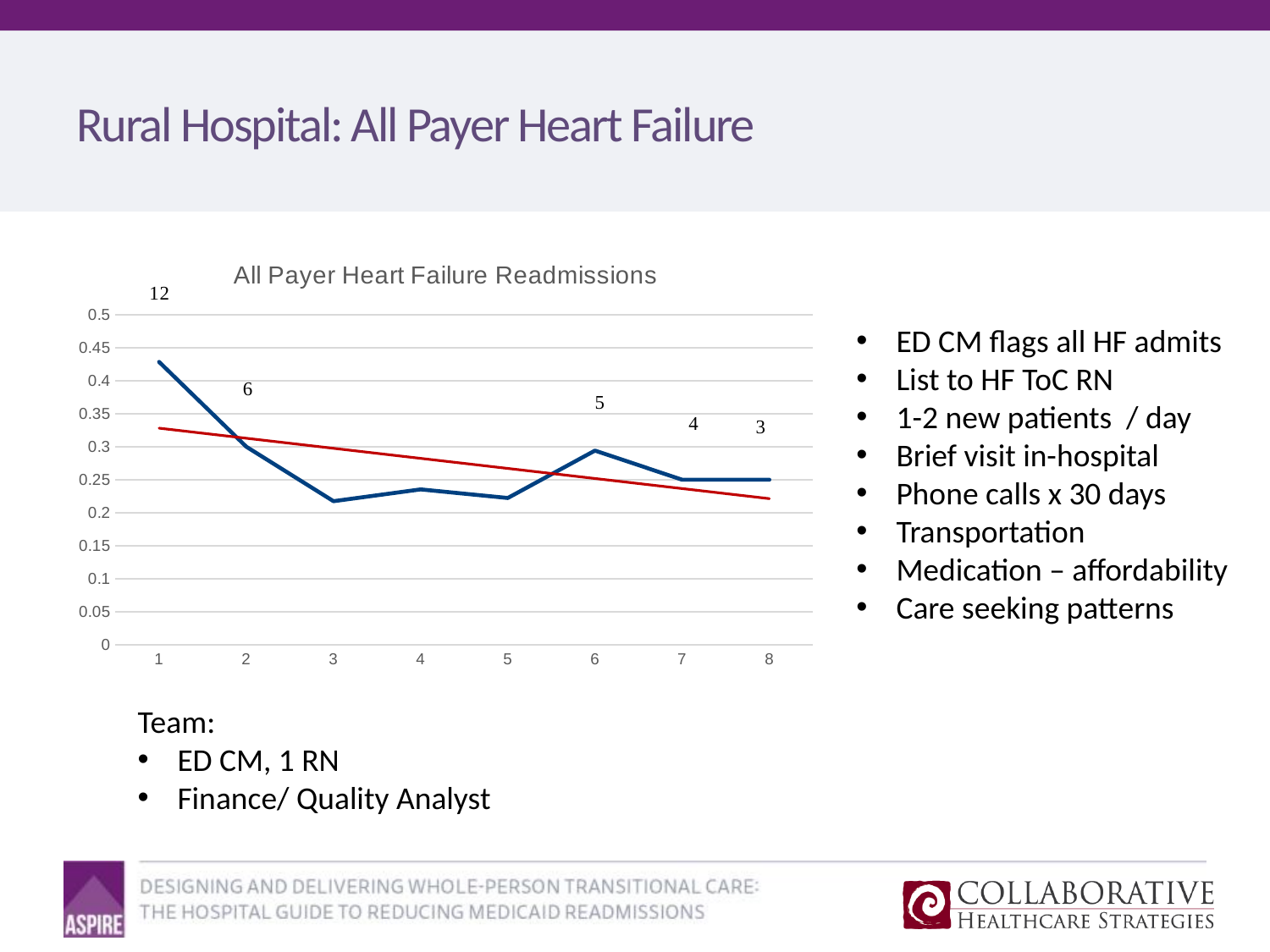
Does the red trend line rise or fall from left to right? fall What number is printed above the blue line at point 8? 3 Which has a higher value on the blue line, point 1 or point 6? point 1 Is the value of the blue line at point 1 greater or less than 0.4? greater What type of chart is shown on the slide? line chart Is the value of the blue line at point 3 greater or less than 0.25? less At which x-axis point is the blue line at its highest value? 1 Is the value of the blue line at point 8 greater or less than 0.3? less What number is printed above the blue line at point 1? 12 What is the title of the chart? All Payer Heart Failure Readmissions How many points are plotted along the x axis of the chart? 8